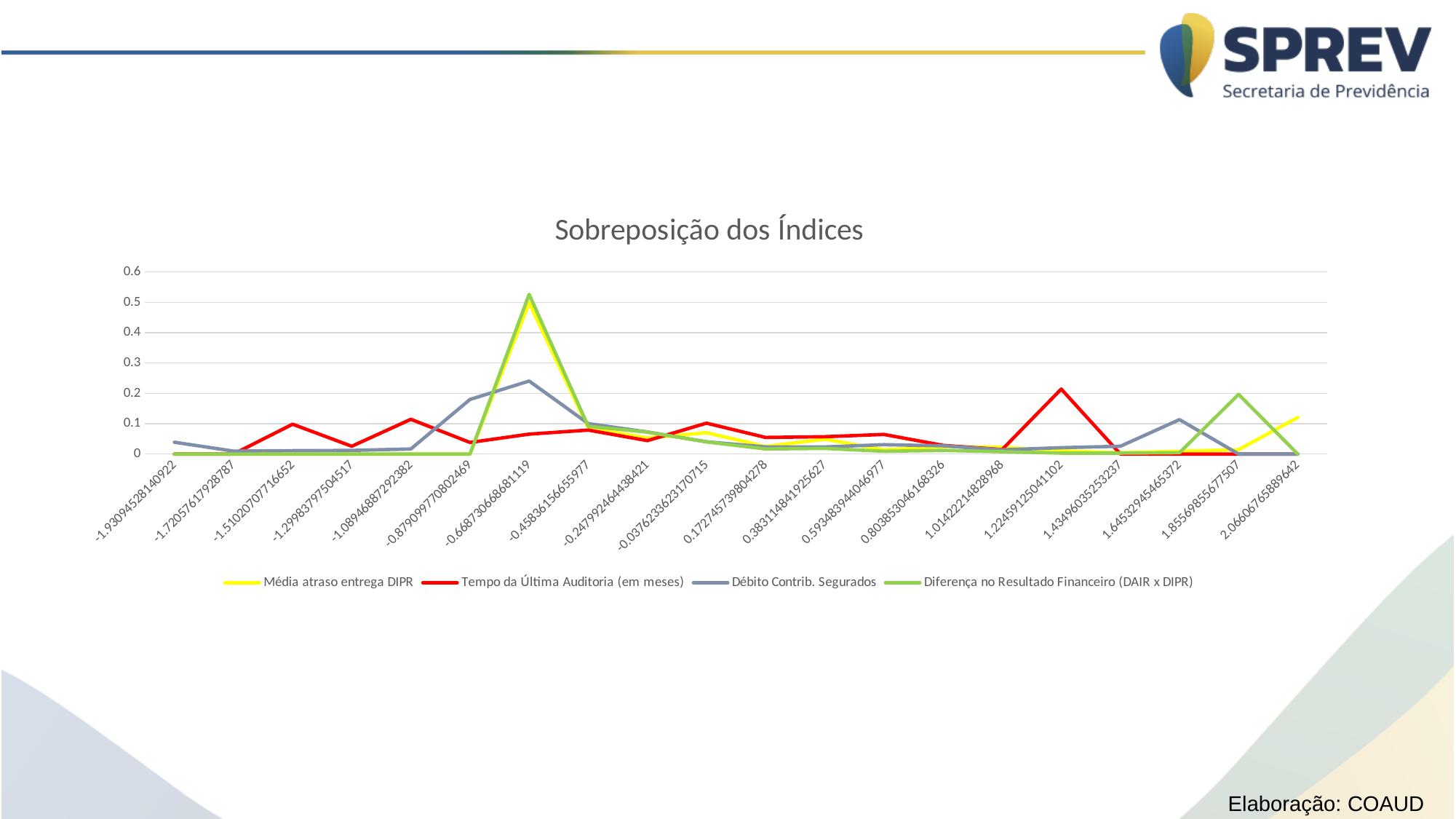
Is the value of 'Débito Contrib. Segurados' at -0.668730668681119 greater or less than 0.1? greater Is the value of 'Diferença no Resultado Financeiro (DAIR x DIPR)' at -0.668730668681119 greater or less than 0.4? greater How many series does the legend list? 4 At which x-axis category does the series 'Diferença no Resultado Financeiro (DAIR x DIPR)' reach its highest value? -0.668730668681119 What is the title of the chart? Sobreposição dos Índices At -0.668730668681119, which series has the larger value: 'Diferença no Resultado Financeiro (DAIR x DIPR)' or 'Débito Contrib. Segurados'? Diferença no Resultado Financeiro (DAIR x DIPR) How many categories are shown along the x axis? 20 What kind of chart is shown on the slide? line chart At which x-axis category does the series 'Tempo da Última Auditoria (em meses)' reach its highest value? 1.22459125041102 Is the value of 'Tempo da Última Auditoria (em meses)' at 1.22459125041102 greater or less than 0.1? greater Which colour is used for the series 'Tempo da Última Auditoria (em meses)'? red At 1.22459125041102, which series has the larger value: 'Tempo da Última Auditoria (em meses)' or 'Débito Contrib. Segurados'? Tempo da Última Auditoria (em meses)